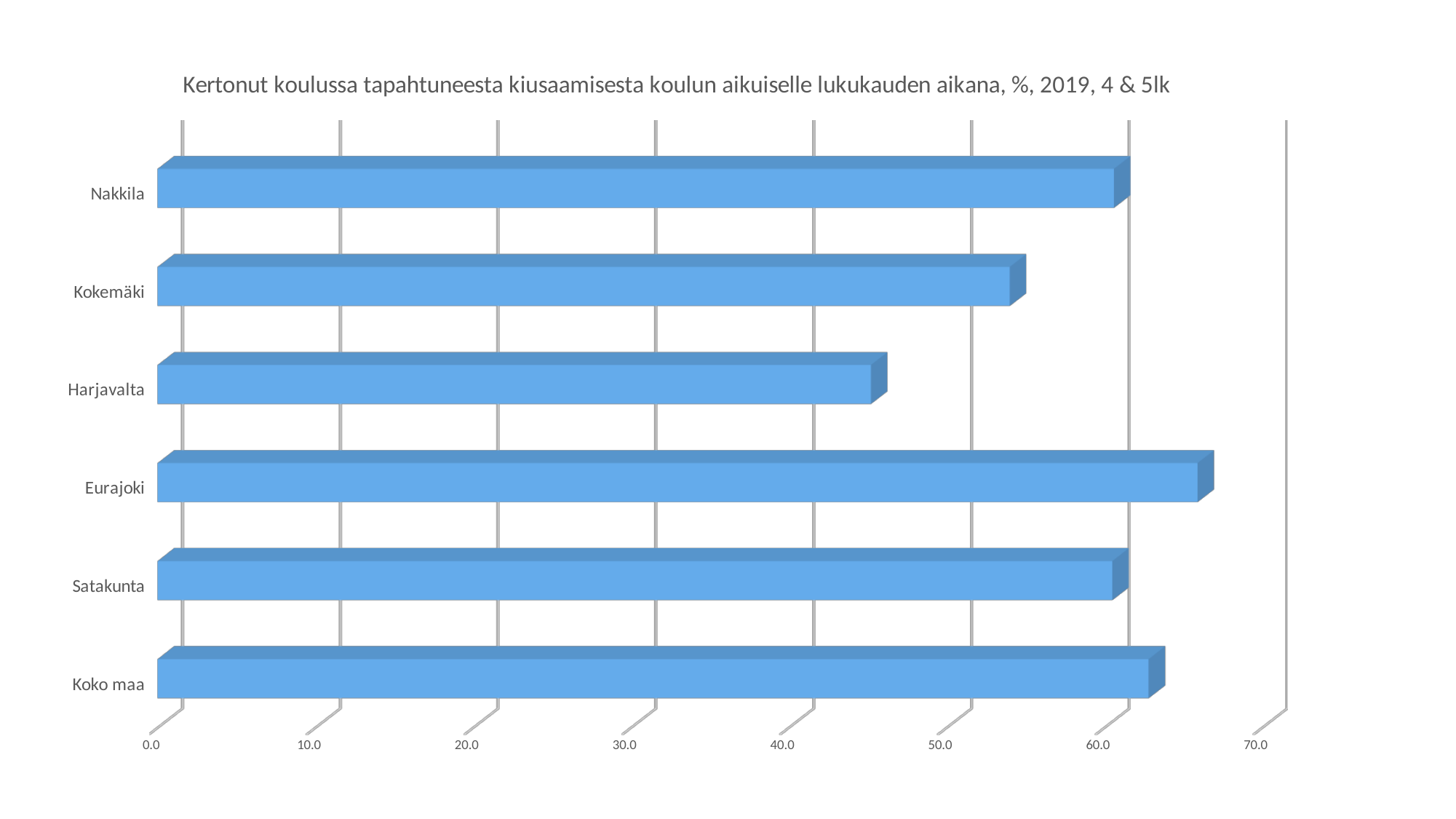
Is the value for Koko maa greater or less than 60? greater Which category has the highest value? Eurajoki Which is larger, the value for Kokemäki or the value for Harjavalta? Kokemäki Is the value for Kokemäki greater or less than 50? greater Is the value for Harjavalta greater or less than 40? greater Which category has the lowest value? Harjavalta Which is larger, the value for Eurajoki or the value for Kokemäki? Eurajoki What kind of chart is shown on the slide? bar chart How many categories are shown in the chart? 6 What is the title of the chart? Kertonut koulussa tapahtuneesta kiusaamisesta koulun aikuiselle lukukauden aikana, %, 2019, 4 & 5lk